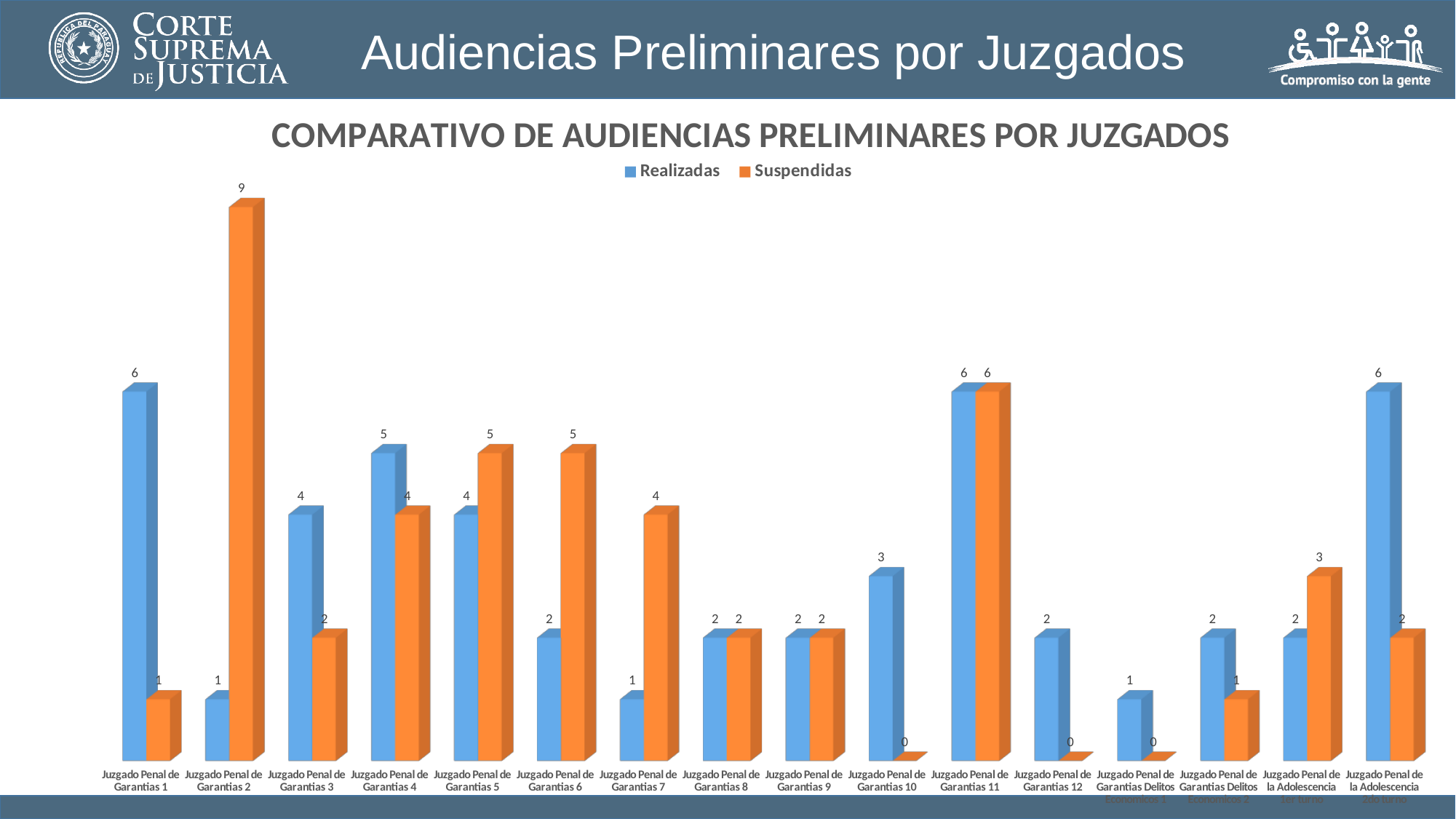
Which juzgado has the highest Suspendidas value? Juzgado Penal de Garantias 2 How many series does the legend list? 2 What is the title of the chart? COMPARATIVO DE AUDIENCIAS PRELIMINARES POR JUZGADOS What is the difference between Realizadas and Suspendidas for Juzgado Penal de Garantias 1? 5 What type of chart is shown on the slide? Bar chart What is the Realizadas value for Juzgado Penal de Garantias 12? 2 What is the Realizadas value for Juzgado Penal de Garantias 4? 5 What is the Suspendidas value for Juzgado Penal de Garantias 2? 9 How many juzgados (categories) are shown on the x axis? 16 What is the total of Realizadas and Suspendidas for Juzgado Penal de Garantias 11? 12 Which is larger for Juzgado Penal de Garantias 7, Realizadas or Suspendidas? Suspendidas What is the Suspendidas value for Juzgado Penal de Garantias 10? 0